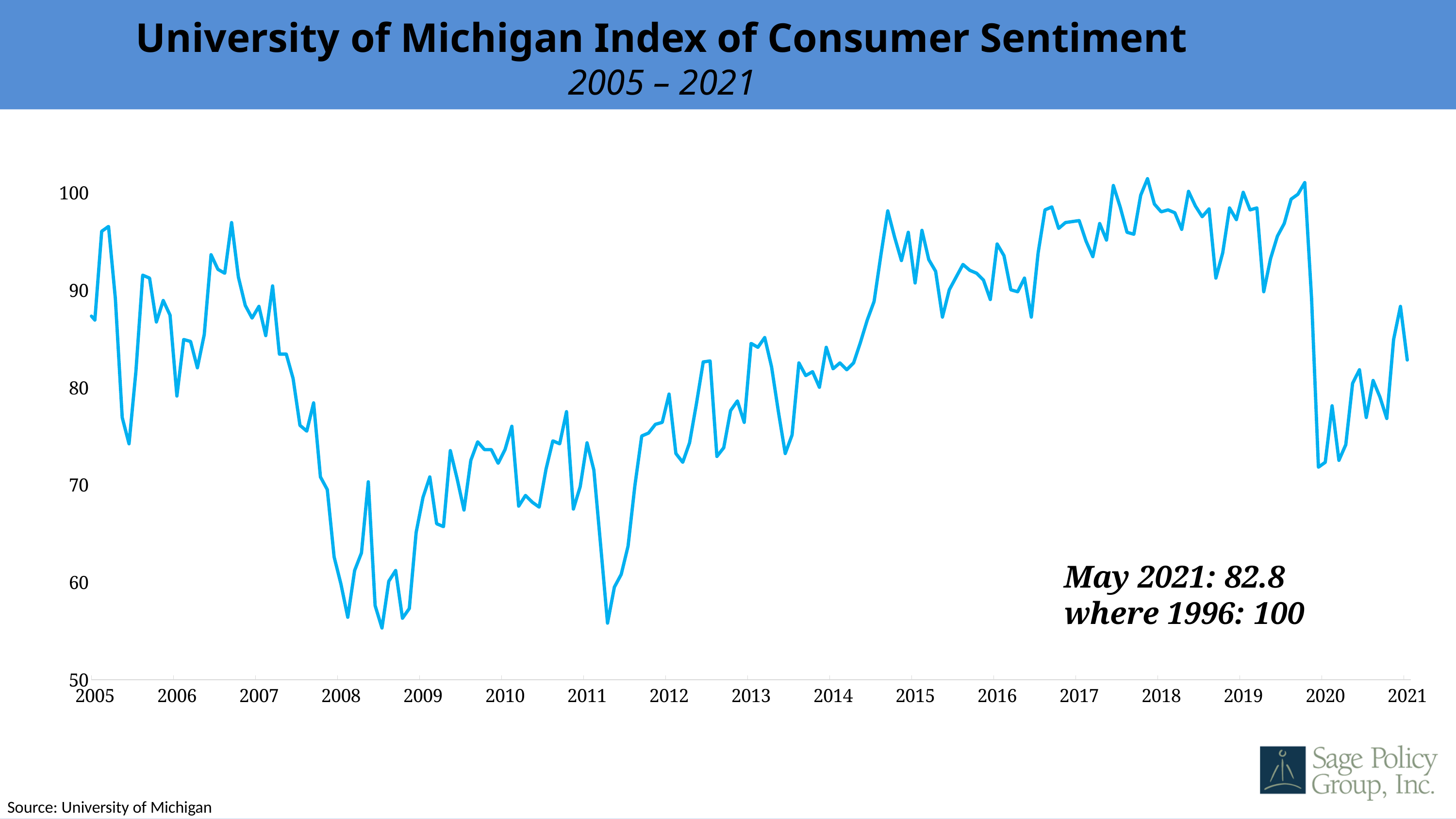
Is the value of the index at the start of 2005 greater or less than 80? greater Does the index generally rise or fall between the start of 2007 and the middle of 2008? fall Is the value of the index at the start of 2015 greater or less than 90? greater Is the lowest value of the index during 2011 greater or less than 60? less What is the value of the index for May 2021, as printed on the slide? 82.8 What is the title of the chart? University of Michigan Index of Consumer Sentiment Does the index generally rise or fall between 2009 and 2015? rise Which year is the base year where the index equals 100? 1996 What kind of chart is shown on the slide? line chart How many year labels are shown on the x axis? 17